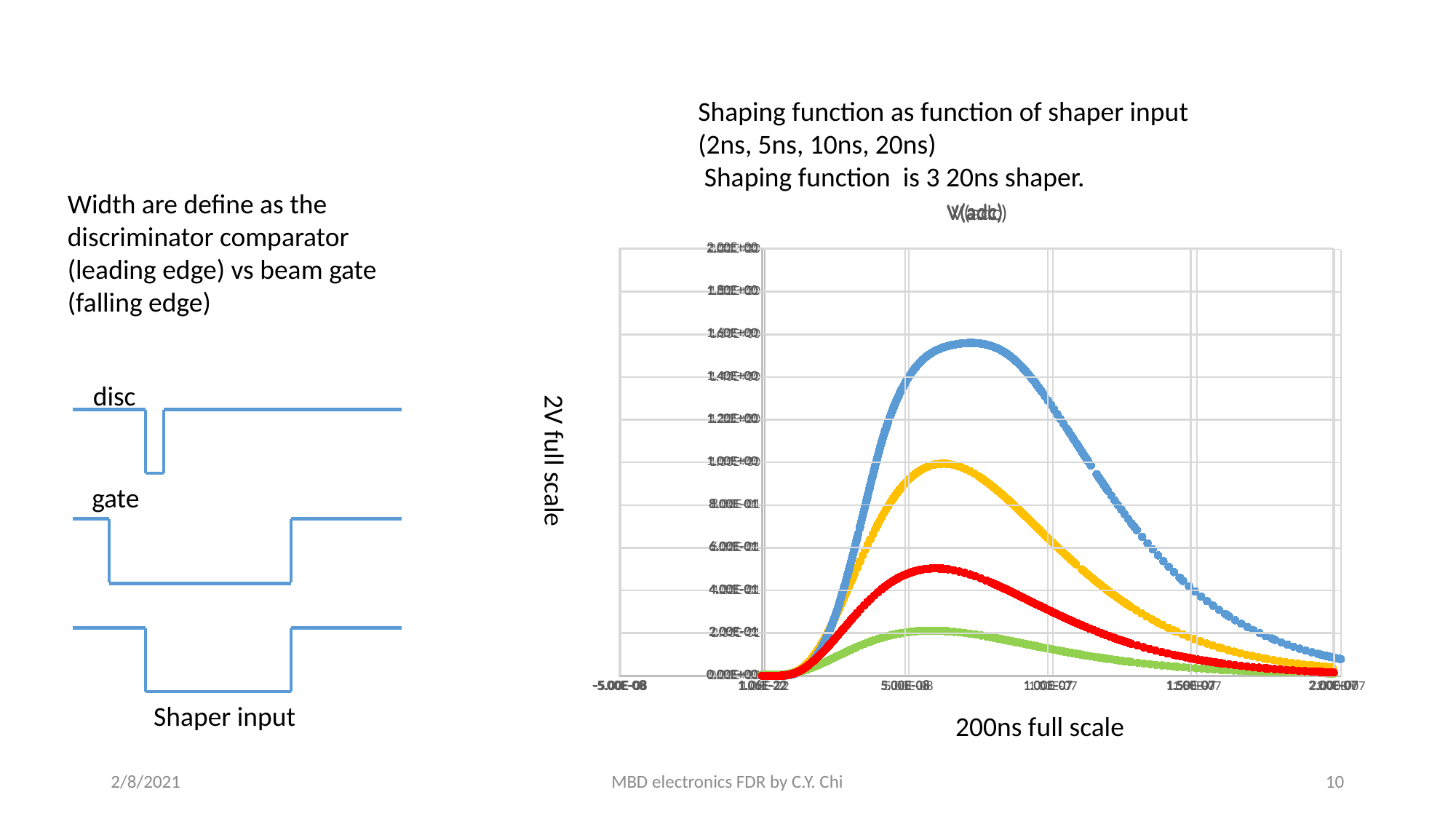
Which curve peaks higher, the red one or the green one? red Which coloured curve has the lowest peak in the chart? green Is the peak value of the blue curve greater or less than 1.40E+00? greater How many curves (series) are plotted in the chart on the right? 4 What full-scale label is written below the horizontal axis of the chart? 200ns full scale Is the peak value of the red curve greater or less than 4.00E-01? greater What kind of chart is shown on the right side of the slide? scatter chart Is the peak value of the green curve greater or less than 6.00E-01? less Which curve peaks higher, the blue one or the yellow one? blue Which coloured curve reaches the highest peak in the chart? blue After reaching its peak, does the blue curve rise or fall toward the right end of the x axis? fall What full-scale label is written next to the vertical axis of the chart? 2V full scale